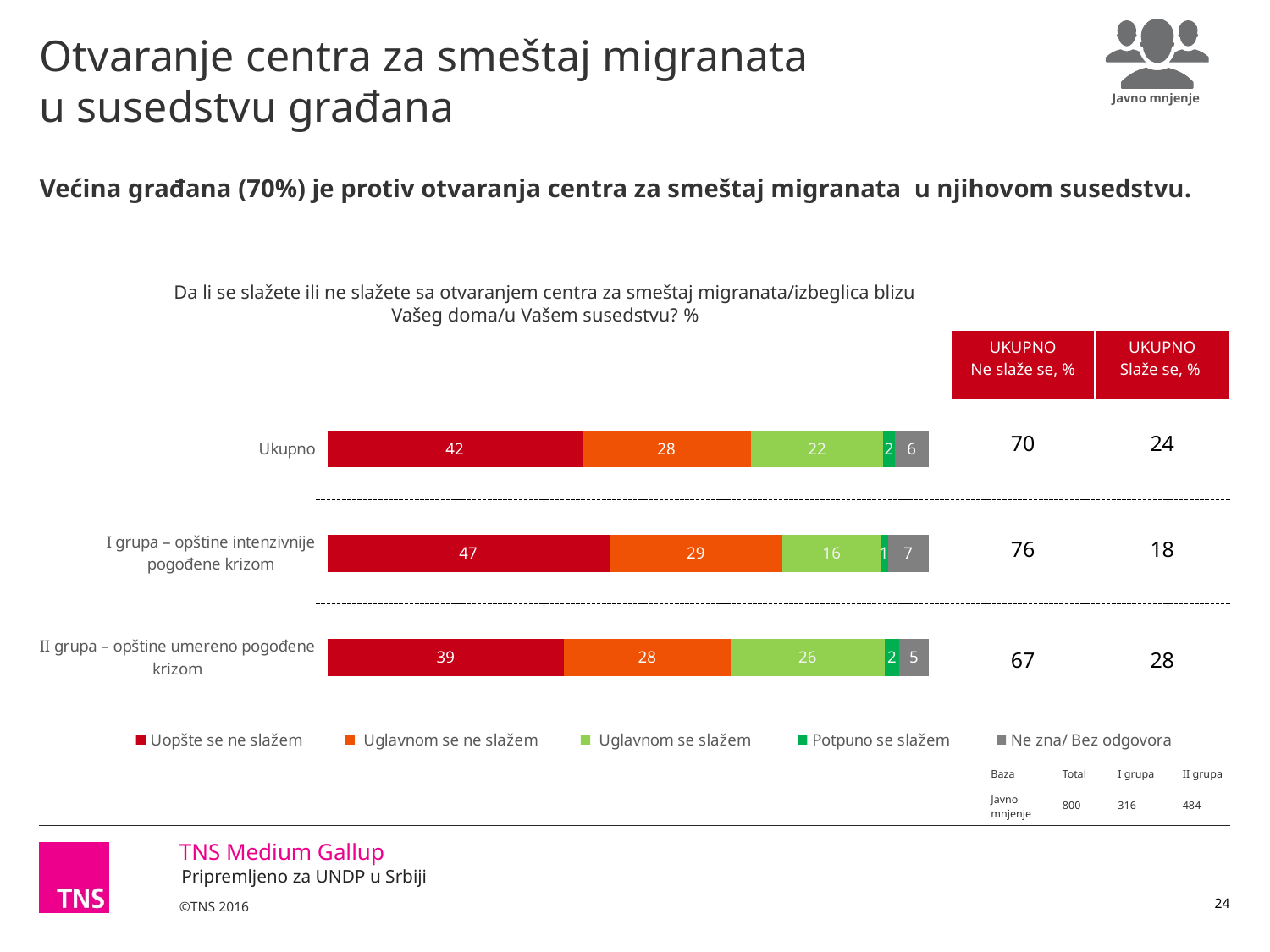
Which is larger: "Uglavnom se slažem" for Ukupno or for II grupa? II grupa How many categories (bars) are plotted in the chart? 3 How many series does the legend list? 5 Which series is shown in dark red in the chart? Uopšte se ne slažem Which category has the lowest value for "Uglavnom se slažem"? I grupa – opštine intenzivnije pogođene krizom Which category has the highest value for "Uopšte se ne slažem"? I grupa – opštine intenzivnije pogođene krizom What is the value of "Uopšte se ne slažem" for Ukupno? 42 What is the value of "Ne zna/ Bez odgovora" for "I grupa – opštine intenzivnije pogođene krizom"? 7 What is the value of "Uglavnom se slažem" for "II grupa – opštine umereno pogođene krizom"? 26 What is the value of "Uglavnom se ne slažem" for "I grupa – opštine intenzivnije pogođene krizom"? 29 What kind of chart is shown on the slide? Stacked bar chart What is the difference between the "Uopšte se ne slažem" values for I grupa and II grupa? 8